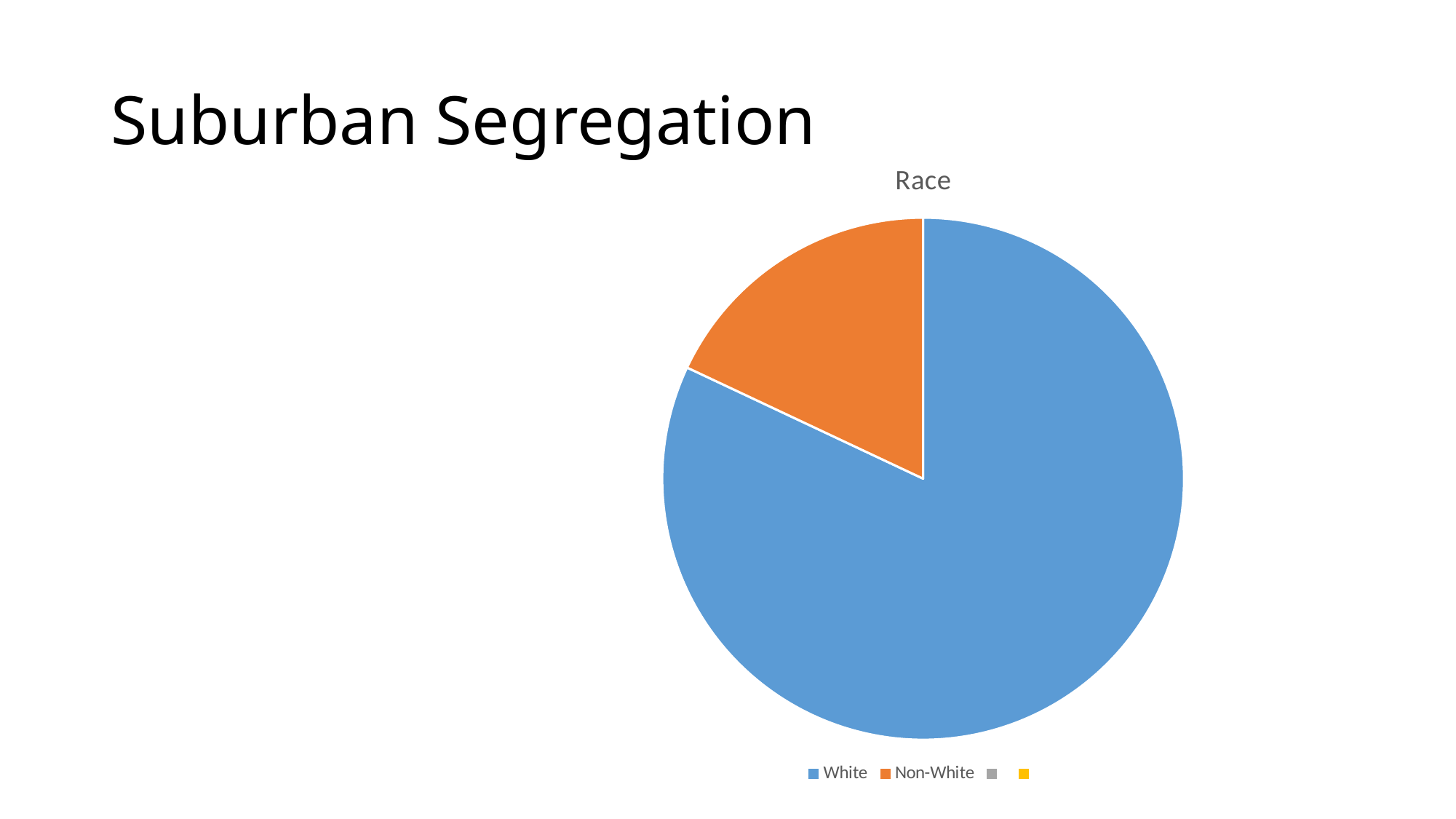
What is the title of the chart? Race How many slices are visible in the pie chart? 2 Which slice is larger, White or Non-White? White Which category has the smallest slice of the pie? Non-White Which colour represents the White category in the pie chart? blue Which category has the largest slice of the pie? White Does the Non-White slice take up more or less than half of the pie? less What kind of chart is shown on the slide? pie chart Does the White slice take up more or less than half of the pie? more